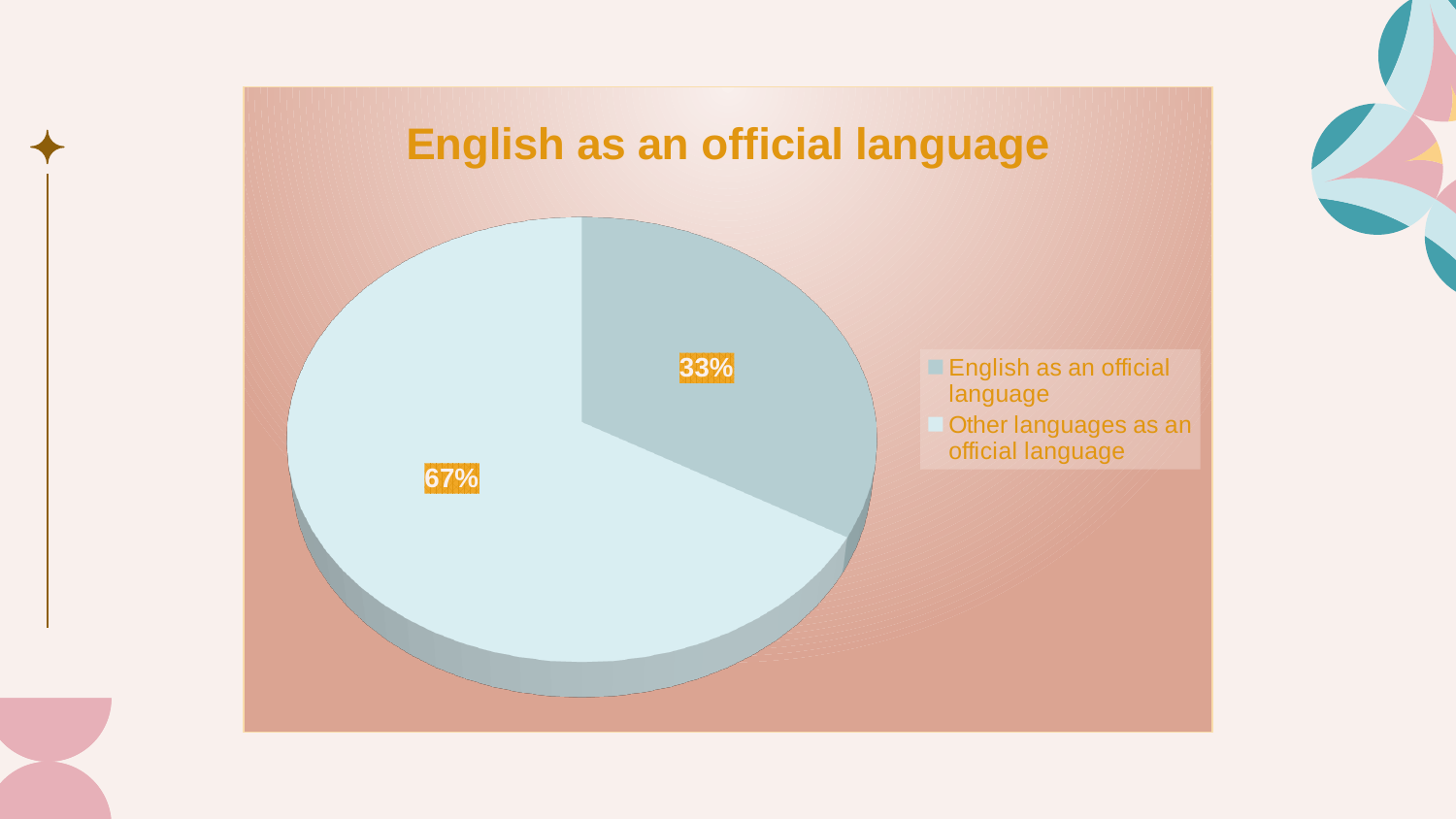
What percentage of the pie is labelled for 'Other languages as an official language'? 67% What kind of chart is shown on the slide? pie chart Which slice of the pie is the smallest? English as an official language Which slice of the pie is the largest? Other languages as an official language What percentage of the pie is labelled for 'English as an official language'? 33% What is the difference in percentage points between the 'Other languages as an official language' slice and the 'English as an official language' slice? 34 Which is larger: the share for 'English as an official language' or the share for 'Other languages as an official language'? Other languages as an official language What is the title of the chart? English as an official language What share of the pie does the 'English as an official language' slice represent? 33% Which legend entry is shown in the lighter colour? Other languages as an official language How many slices does the pie chart have? 2 How many entries does the legend list? 2